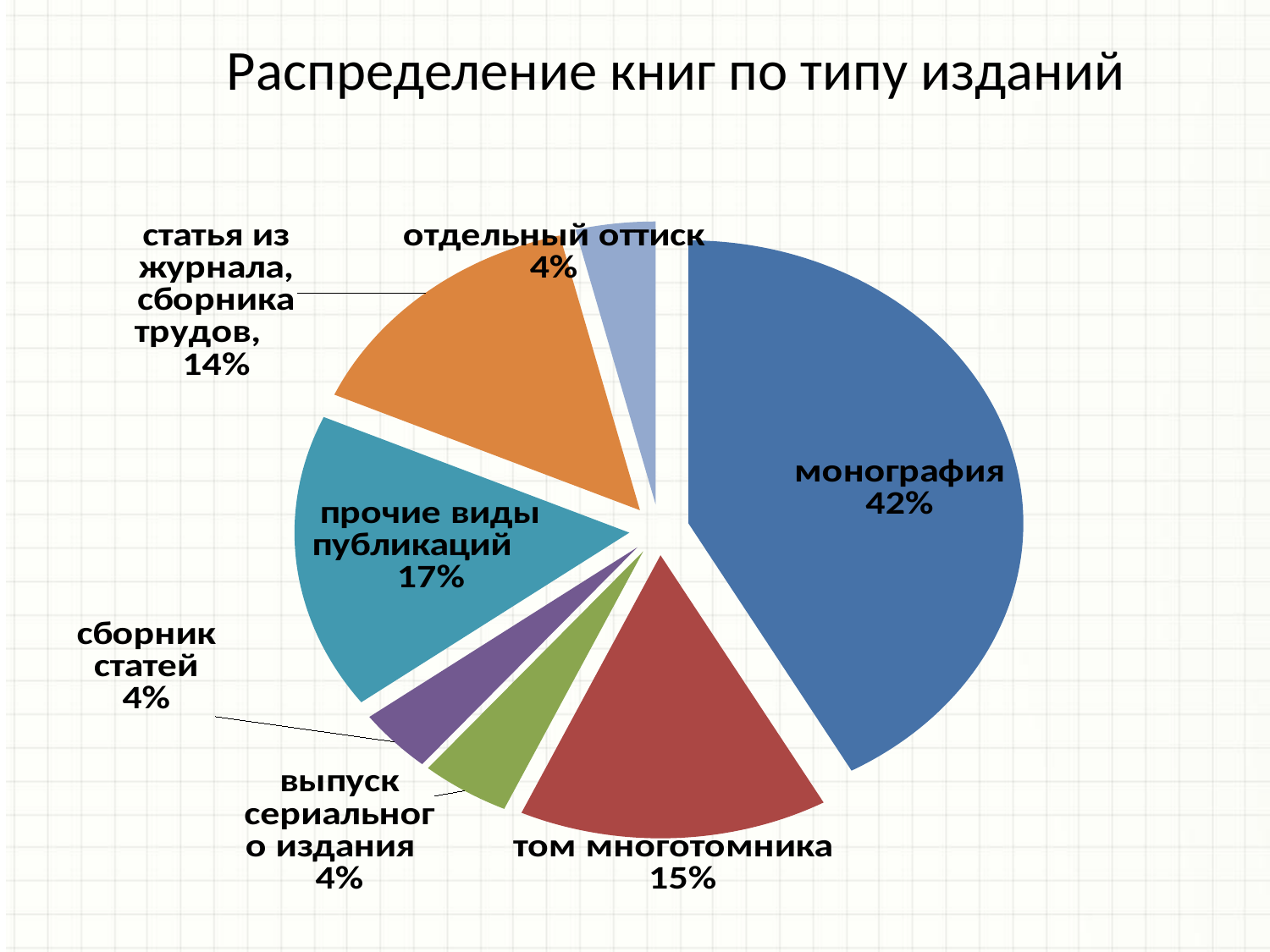
What percentage is shown for том многотомника? 15% How many slices does the pie chart have? 7 Which category has the largest share of the pie? монография What percentage is shown for отдельный оттиск? 4% Which is larger, the share for том многотомника or the share for статья из журнала, сборника трудов? том многотомника What kind of chart is shown on the slide? pie chart What percentage is shown for прочие виды публикаций? 17% What is the difference in percentage points between монография and прочие виды публикаций? 25 What is the title of the chart? Распределение книг по типу изданий What percentage is shown for статья из журнала, сборника трудов? 14% What share of the pie does монография take? 42% What is the difference in percentage points between прочие виды публикаций and сборник статей? 13